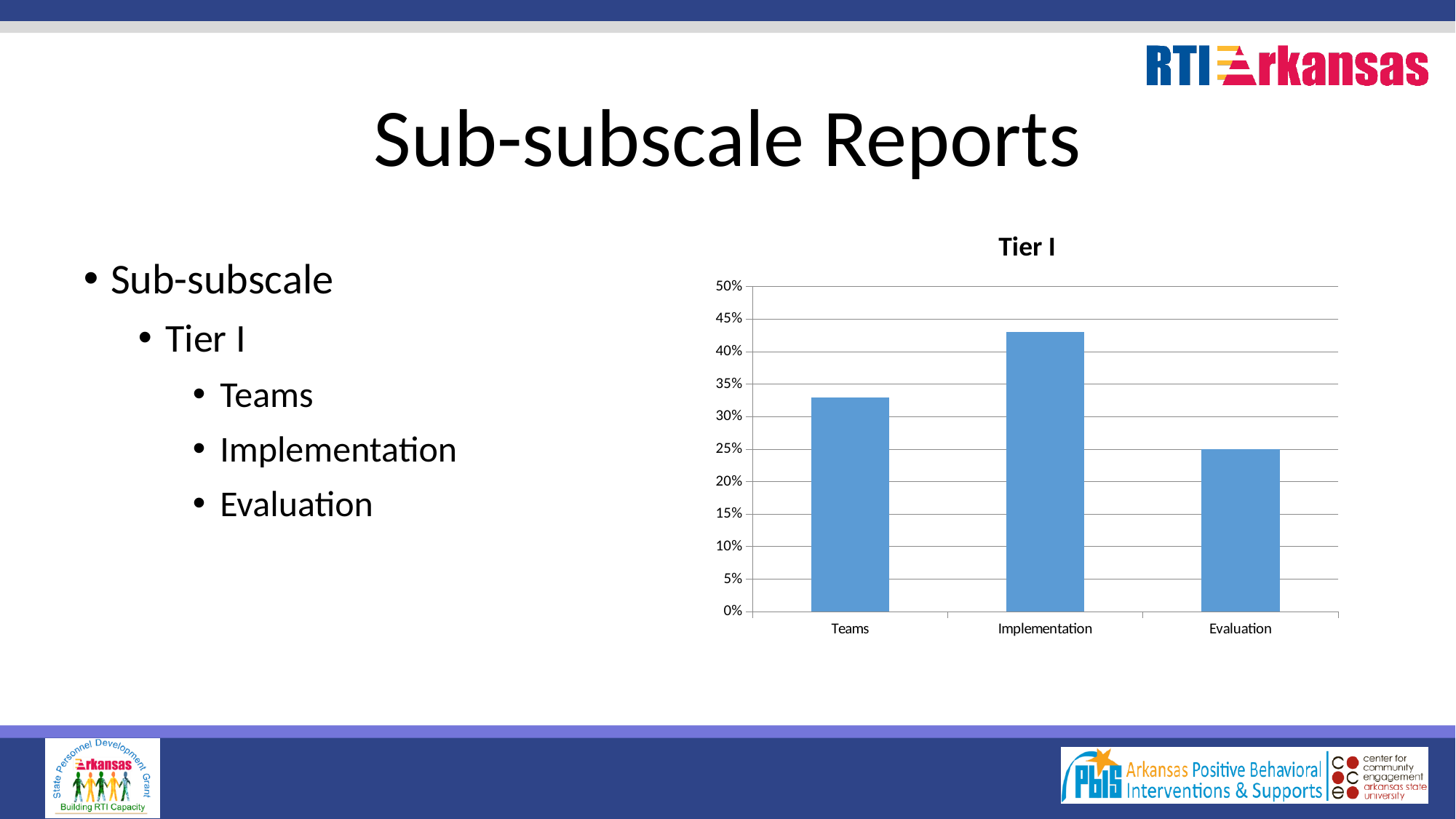
Which category has the highest value in the chart? Implementation What is the title of the chart? Tier I What is the highest value shown on the y axis of the chart? 50% Which is larger, the value for Teams or the value for Evaluation? Teams Is the value for Teams greater or less than 35%? less Is the value for Implementation greater or less than 40%? greater Which category has the lowest value in the chart? Evaluation What is the value for Evaluation? 25% What kind of chart is shown on the slide? bar chart How many categories are shown on the x axis of the chart? 3 Is the value for Implementation greater or less than 45%? less